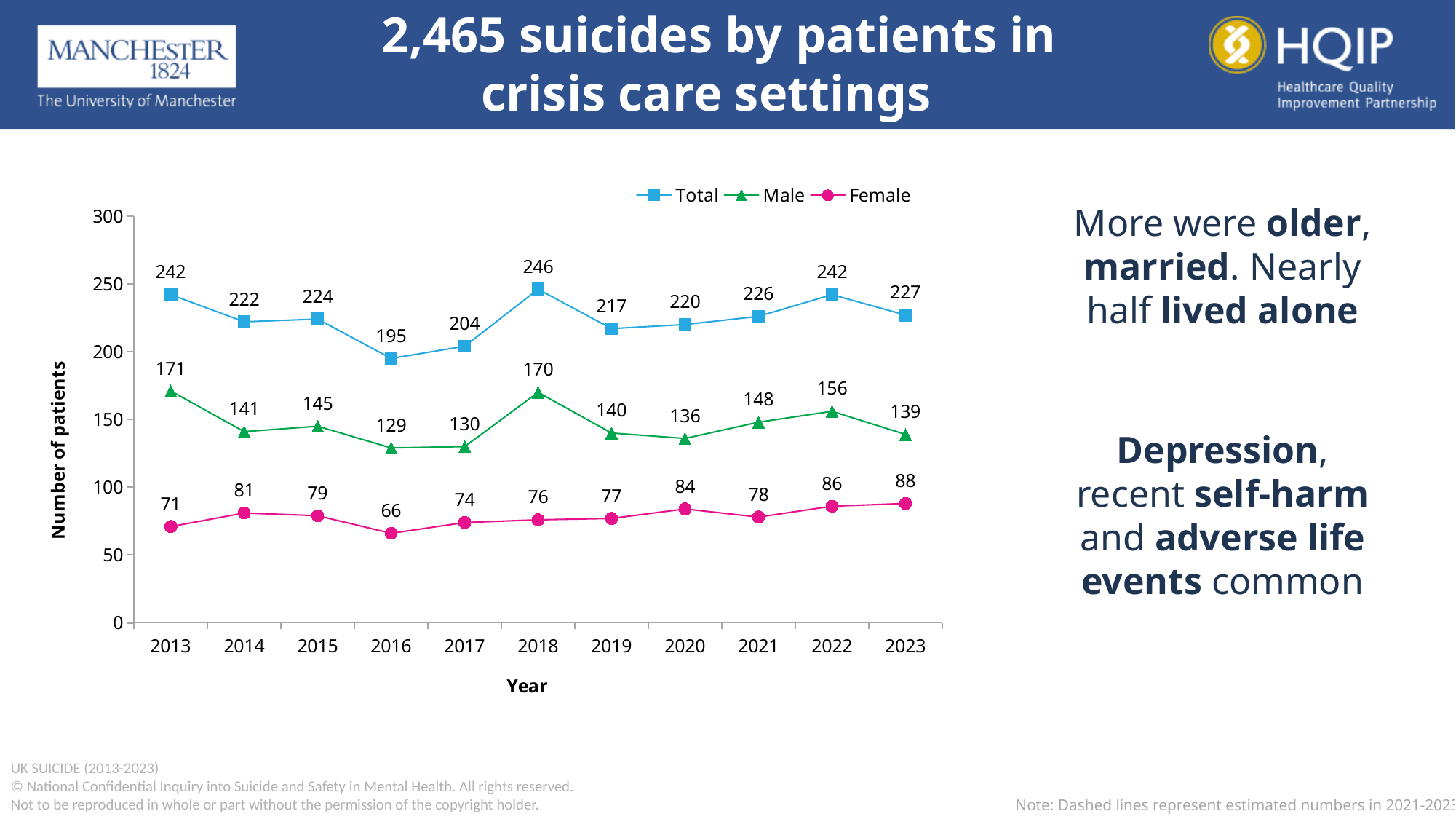
What was the Total number of patients in 2018? 246 How many years are shown on the x axis? 11 What is the label of the y axis? Number of patients How many series does the legend list? 3 Which is larger, the Total value in 2013 or the Total value in 2023? 2013 In which year was the Male value highest? 2013 What is the difference between the Male and Female values in 2022? 70 In which year was the Total number of patients lowest? 2016 In which year was the Female value lowest? 2016 What kind of chart is shown on the slide? Line chart What was the Female value in 2023? 88 What was the Male value in 2016? 129